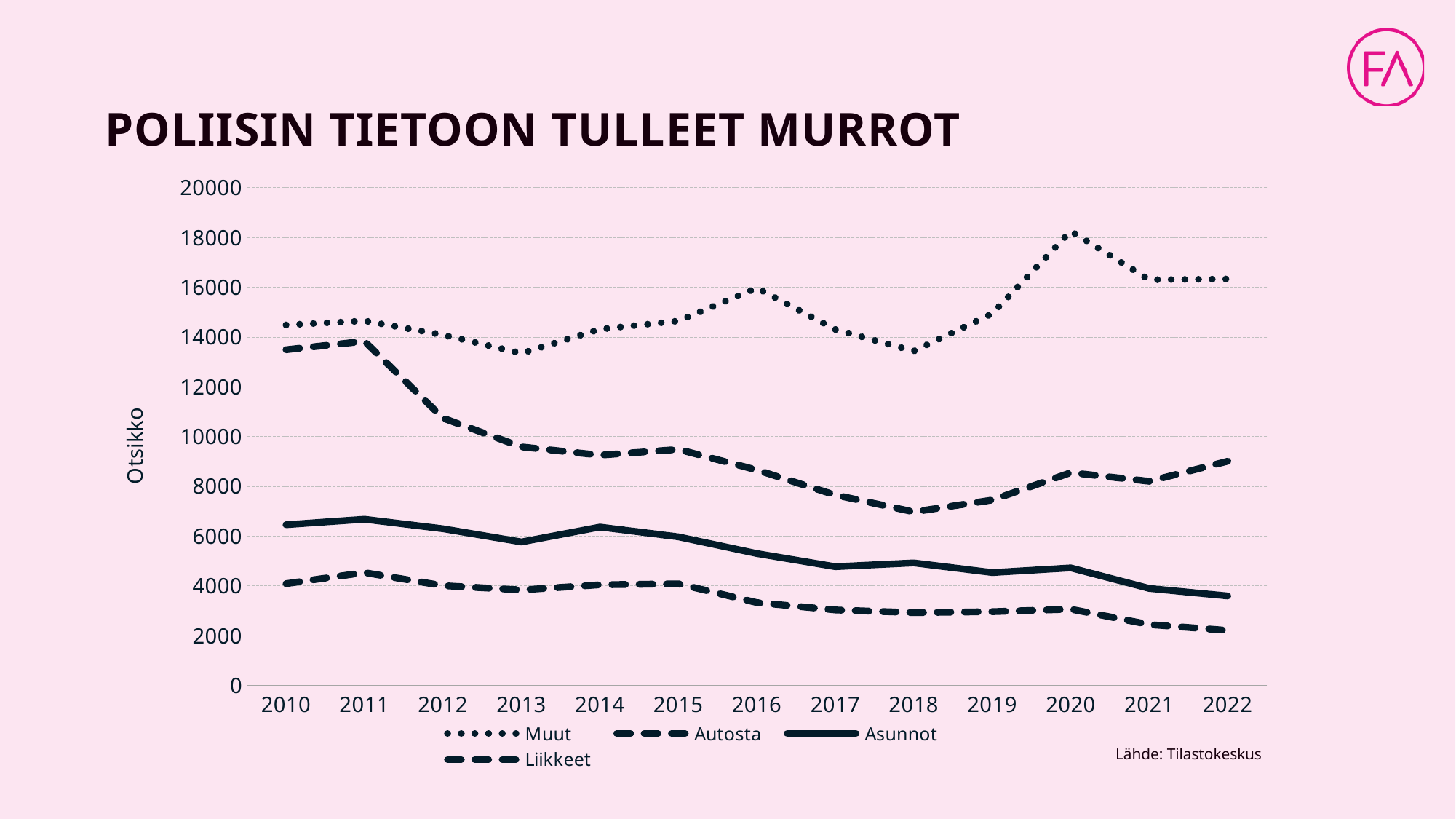
Which series has the highest values across all years shown? Muut Does the Asunnot series rise or fall from 2010 to 2022? fall In which year does the Asunnot series reach its lowest value? 2022 How many years are shown on the x axis? 13 In which year does the Muut series reach its highest value? 2020 Is the value for Asunnot in 2022 greater or less than 4000? less What is the title of the chart? POLIISIN TIETOON TULLEET MURROT Is the value for Muut in 2020 greater or less than 16000? greater Is the value for Muut in 2018 greater or less than 14000? less Which series is higher in 2016, Muut or Asunnot? Muut How many series does the legend list? 4 What kind of chart is shown on the slide? line chart